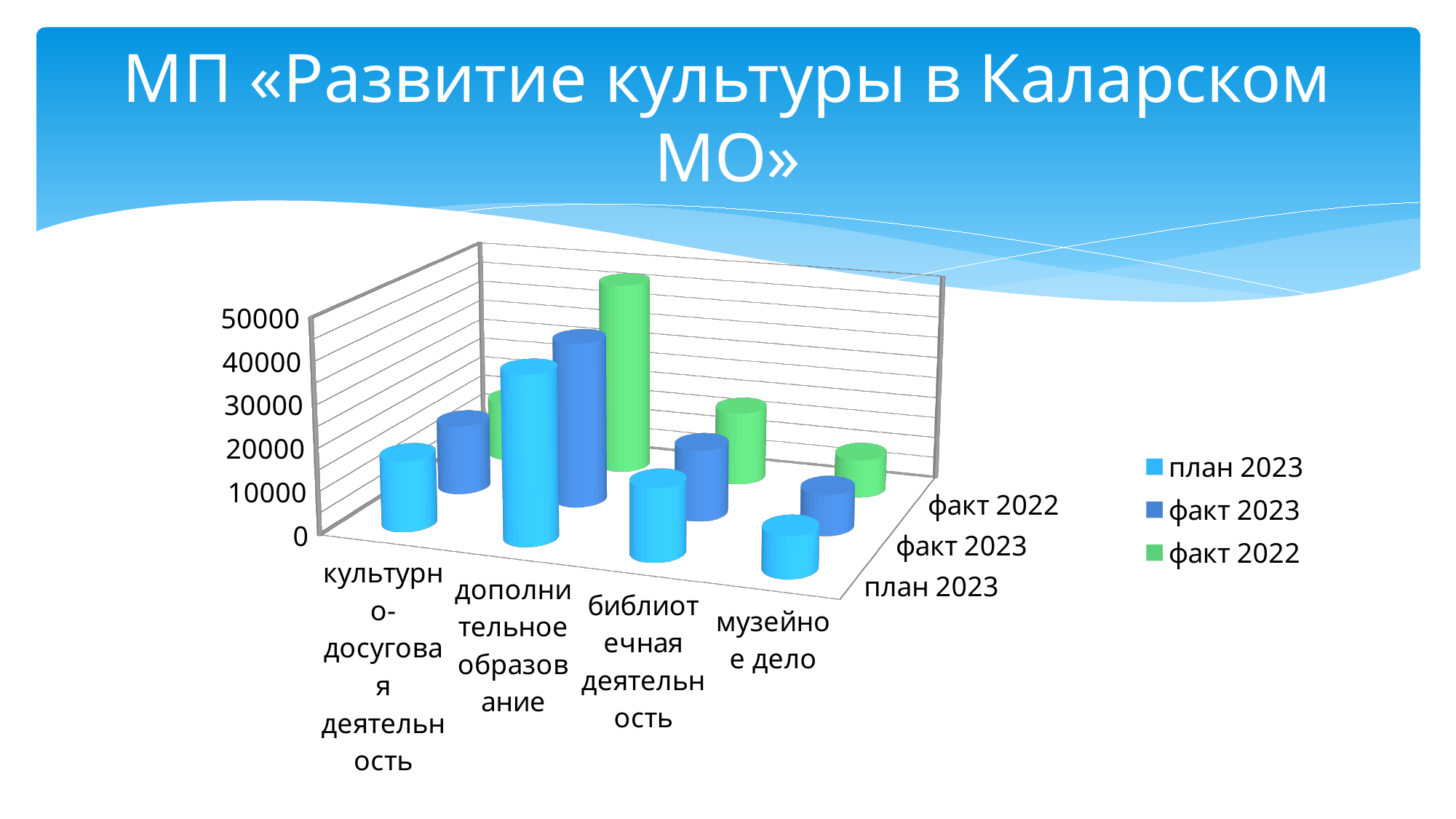
Which category has the lowest value for план 2023? музейное дело How many categories are shown on the x axis of the chart? 4 Which category has the lowest value for факт 2023? музейное дело Which category has the highest value for факт 2022? дополнительное образование What is the title of the slide containing the chart? МП «Развитие культуры в Каларском МО» Which category has the highest value for план 2023? дополнительное образование What kind of chart is shown on the slide? bar chart For план 2023, which is larger: дополнительное образование or библиотечная деятельность? дополнительное образование Is the план 2023 value for дополнительное образование greater or less than 20000? greater How many series does the chart legend list? 3 Which series is shown in green in the chart legend? факт 2022 Is the план 2023 value for музейное дело greater or less than 20000? less